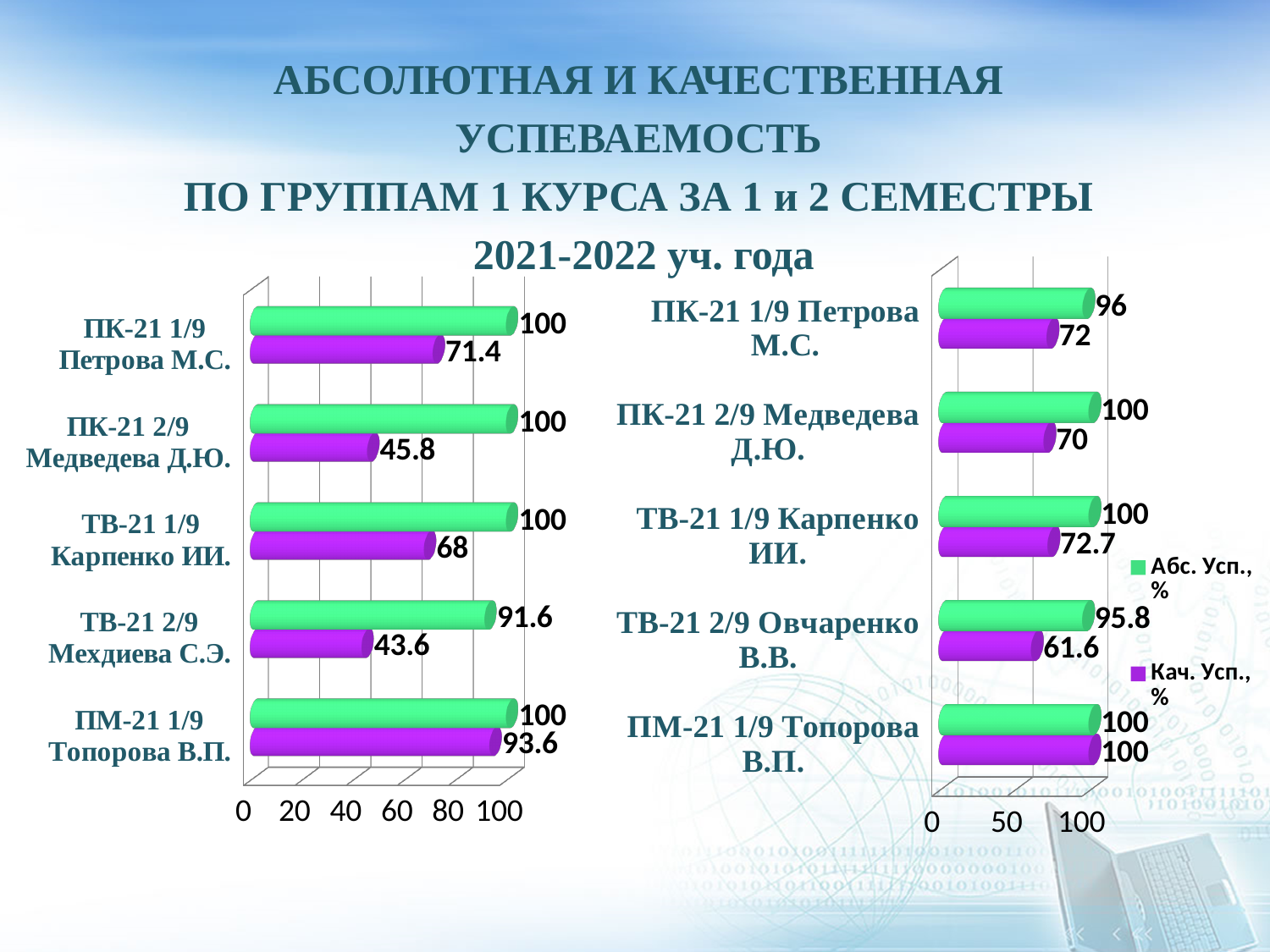
How many series does the legend of the right chart list? 2 What type of chart is the left chart? Bar chart In the right chart, which is larger: the Кач. Усп., % value for ПК-21 1/9 Петрова М.С. or for ПК-21 2/9 Медведева Д.Ю.? ПК-21 1/9 Петрова М.С. In the left chart, what is the value of the purple bar for ТВ-21 2/9 Мехдиева С.Э.? 43.6 In the left chart, which category has the lowest purple bar value? ТВ-21 2/9 Мехдиева С.Э. In the left chart, what is the difference between the green and purple bar values for ПК-21 2/9 Медведева Д.Ю.? 54.2 In the right chart, what is the Абс. Усп., % value for ПК-21 1/9 Петрова М.С.? 96 How many categories are shown in the right chart? 5 In the right chart, which category has the lowest Кач. Усп., % value? ТВ-21 2/9 Овчаренко В.В. In the left chart, which category has the highest purple bar value? ПМ-21 1/9 Топорова В.П. In the left chart, what is the value of the green bar for ТВ-21 2/9 Мехдиева С.Э.? 91.6 In the right chart, what is the Кач. Усп., % value for ТВ-21 2/9 Овчаренко В.В.? 61.6